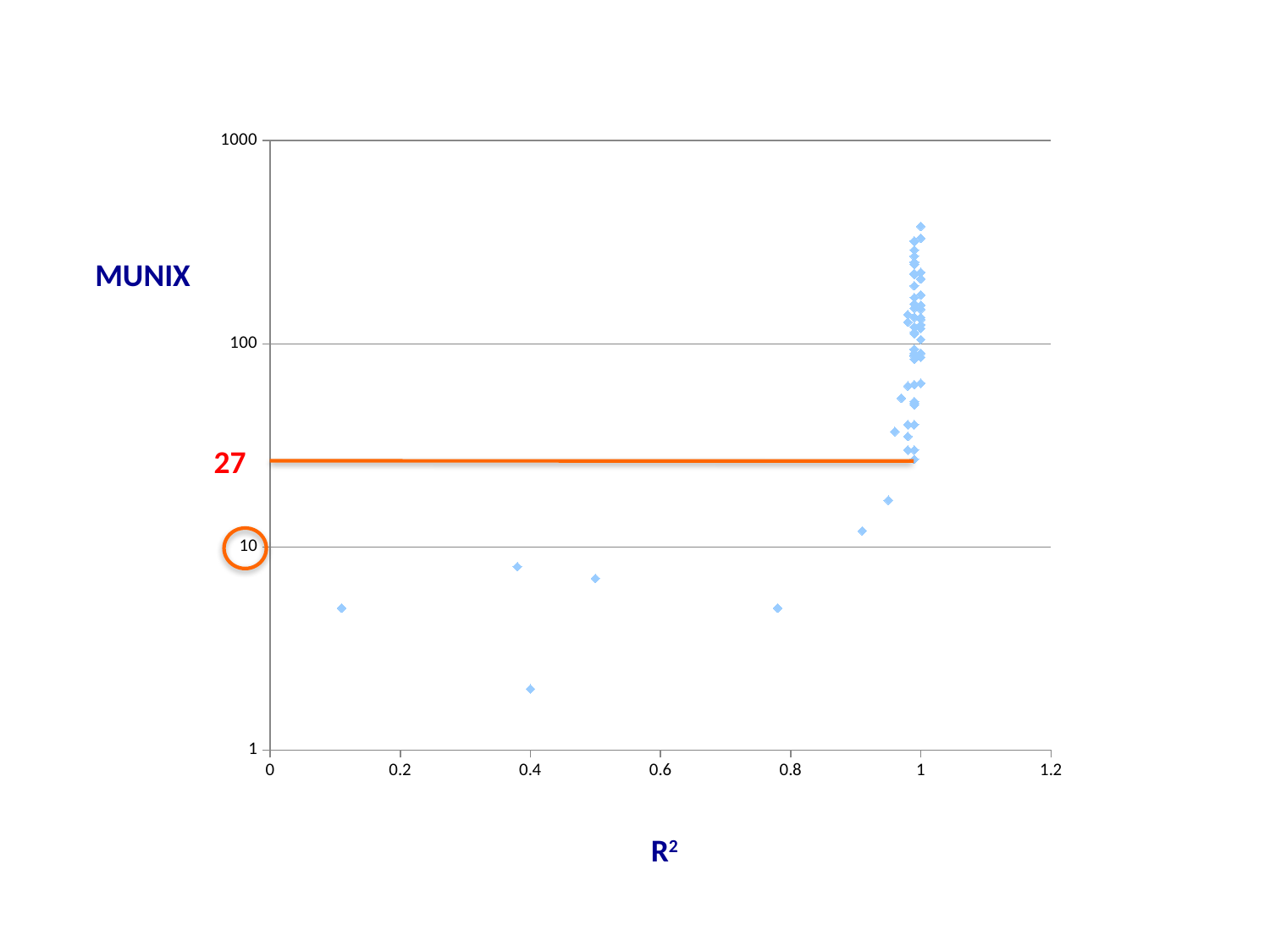
Near which R² value are most of the data points clustered? 1 What is the highest tick value shown on the R² axis? 1.2 How many data points lie below the MUNIX value of 10? 5 Do MUNIX values generally rise or fall as R² increases? rise What kind of chart is shown on the slide? scatter plot How many data points lie between the MUNIX gridline at 10 and the orange line at 27? 2 What MUNIX value does the orange horizontal line mark? 27 Is the MUNIX value of the highest point (near R² = 1) greater or less than 100? greater What is the highest tick value shown on the MUNIX axis? 1000 What is the label of the x axis? R² What is the label of the y axis? MUNIX Is the MUNIX value of the lowest point (near R² = 0.4) greater or less than 10? less